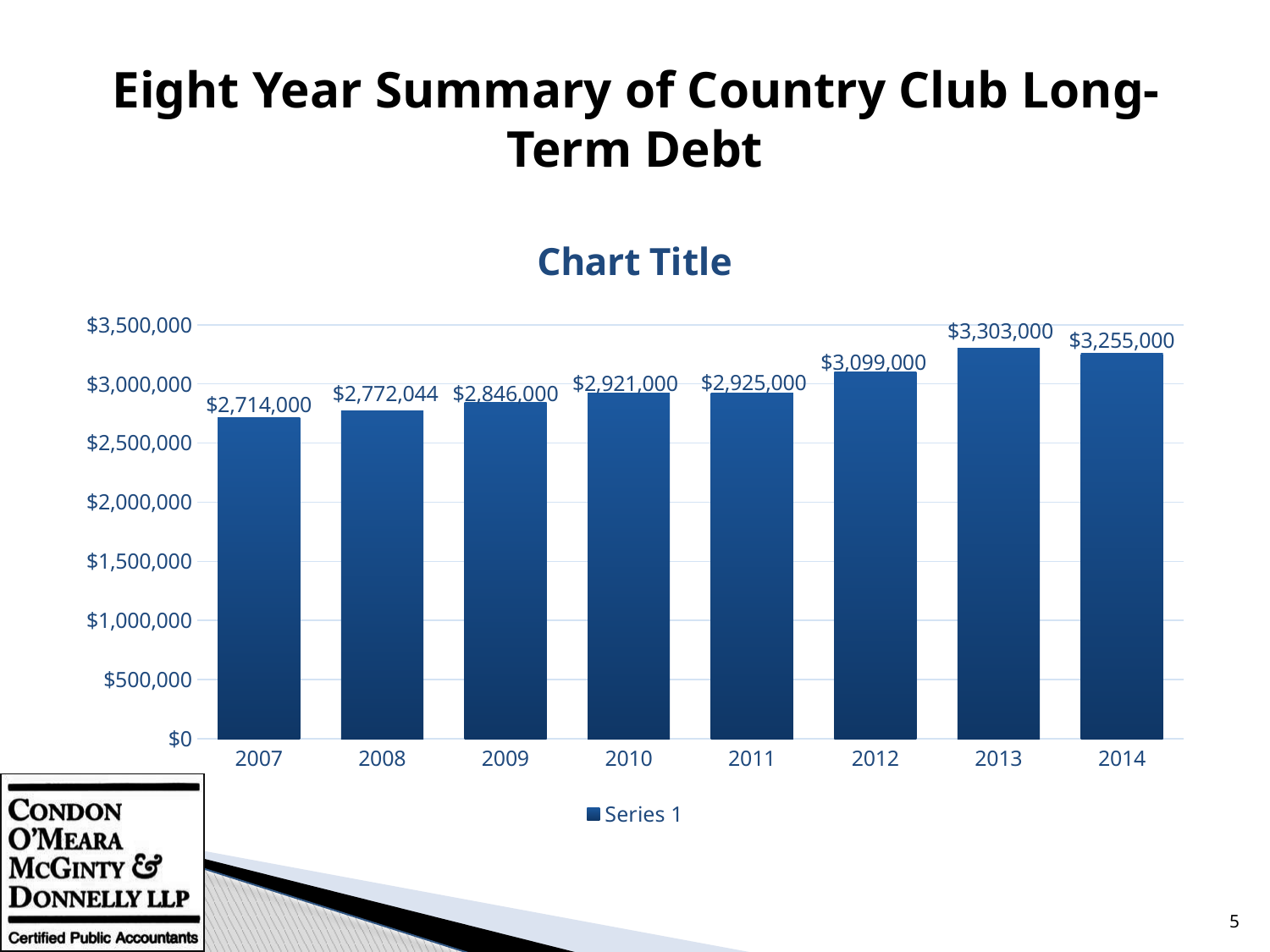
What kind of chart is shown? bar chart How many years are shown on the x axis? 8 What is the value for 2012? $3,099,000 Which is larger, the value for 2009 or the value for 2012? 2012 Do the values generally rise or fall from 2007 to 2013? rise What is the difference between the values for 2013 and 2014? $48,000 What is the value for 2014? $3,255,000 Which year has the lowest value? 2007 What is the value for 2008? $2,772,044 Is the value for 2010 greater or less than $3,000,000? less Which year has the highest value? 2013 What is the value for 2007? $2,714,000